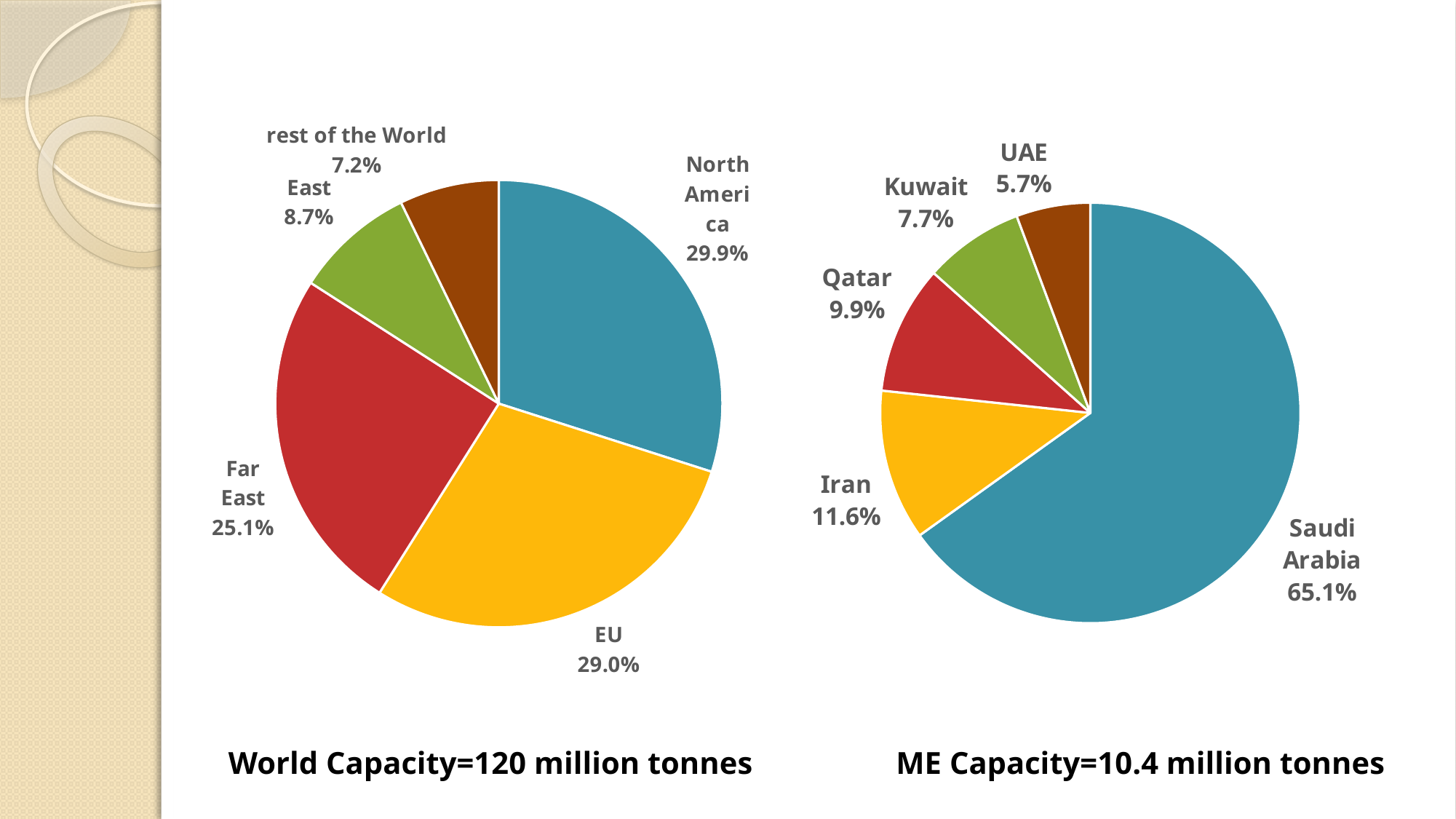
In the left pie chart (World Capacity), what share does the Far East have? 25.1% In the left pie chart (World Capacity), which is larger, the East share or the rest of the World share? East In the right pie chart (ME Capacity), which country has the smallest share? UAE What type of chart is used on the left side of the slide? Pie chart In the right pie chart (ME Capacity), what is the difference in percentage points between Saudi Arabia and Iran? 53.5 In the left pie chart (World Capacity), which region has the smallest share? rest of the World In the right pie chart (ME Capacity), which country has the largest share? Saudi Arabia In the right pie chart (ME Capacity), what share does Kuwait have? 7.7% In the left pie chart (World Capacity), what share does North America have? 29.9% How many slices does the right pie chart (ME Capacity) have? 5 In the left pie chart (World Capacity), what is the difference in percentage points between the EU and the Far East shares? 3.9 In the right pie chart (ME Capacity), what share does Iran have? 11.6%